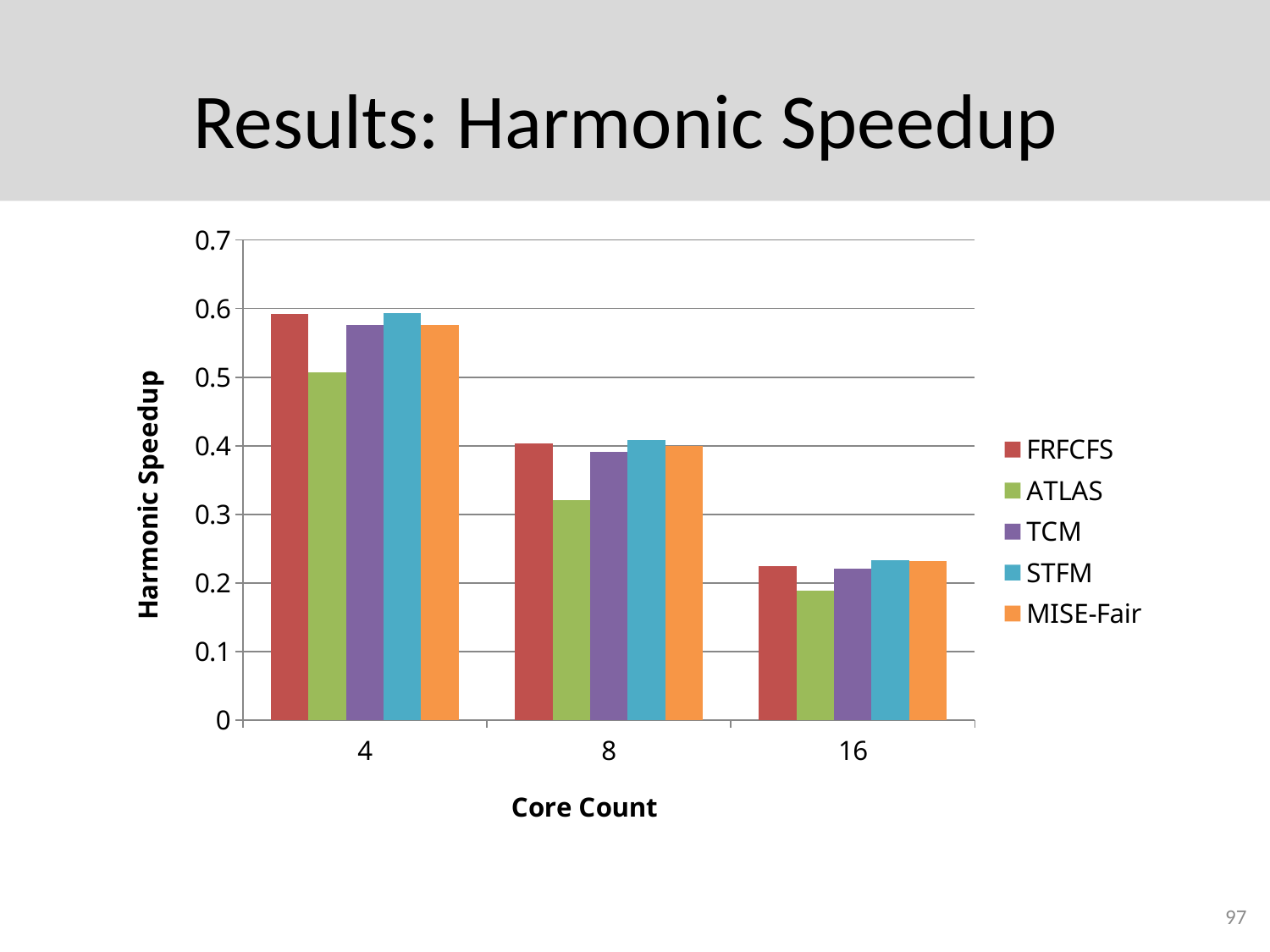
Which scheduler has the lowest harmonic speedup at a core count of 4? ATLAS Is the harmonic speedup for ATLAS at 8 cores greater or less than 0.3? greater What kind of chart is shown on the slide? bar chart Is the harmonic speedup for TCM at 8 cores greater or less than 0.5? less Is the harmonic speedup for MISE-Fair at 4 cores greater or less than 0.5? greater How many core count categories are shown on the x axis? 3 Does the harmonic speedup for FRFCFS rise or fall as the core count increases from 4 to 16? fall Which scheduler has the lowest harmonic speedup at a core count of 8? ATLAS Which scheduler has the lowest harmonic speedup at a core count of 16? ATLAS What is the label of the y axis? Harmonic Speedup How many series does the legend list? 5